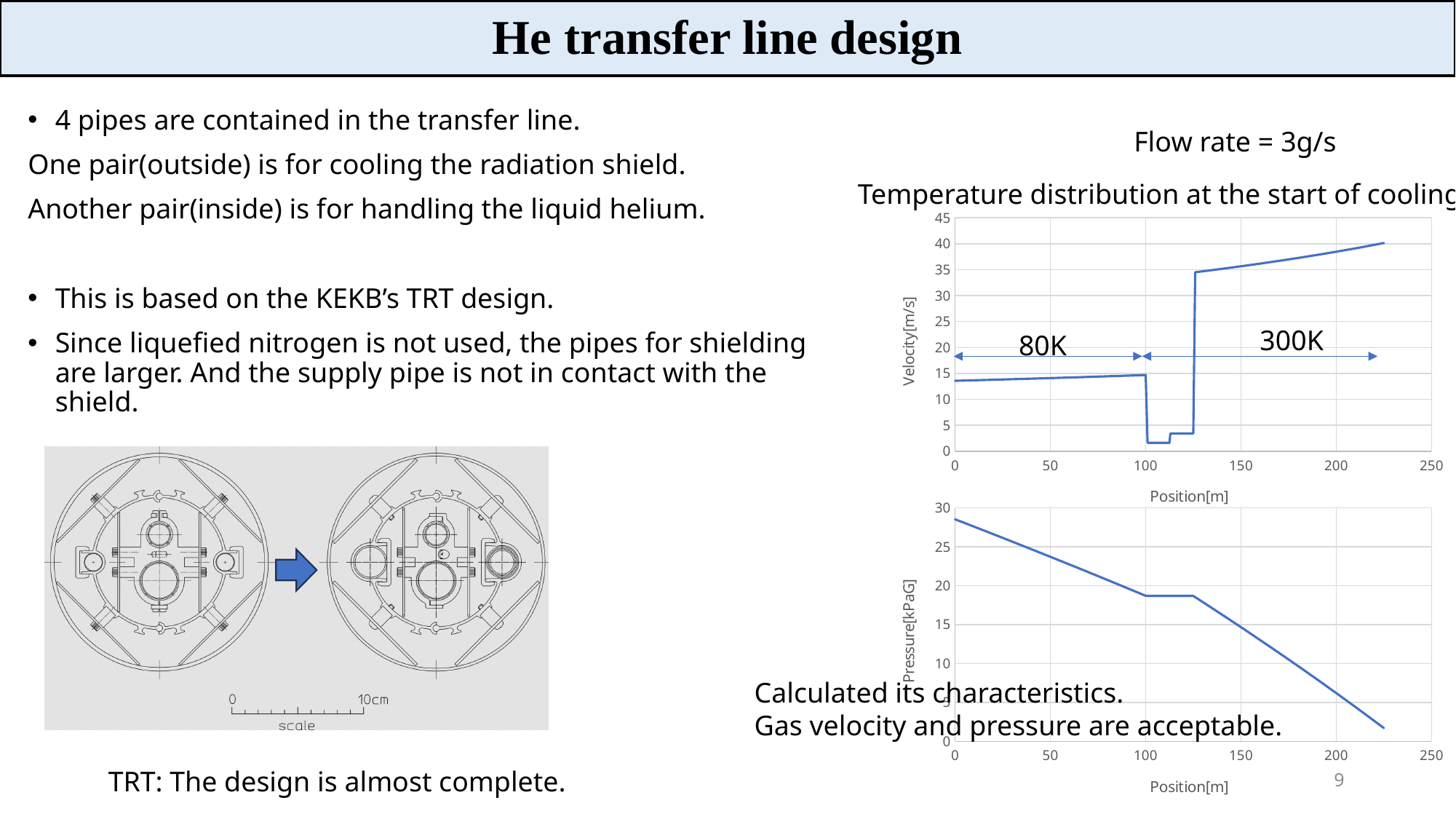
In the top velocity chart, is the velocity at position 225 m greater or less than 35 m/s? greater What is the y-axis label of the bottom chart? Pressure[kPaG] In the top velocity chart, is the velocity higher at position 50 m or at position 200 m? 200 m In the top velocity chart, is the velocity at position 150 m greater or less than 30 m/s? greater How many charts are shown on the slide? 2 In the top velocity chart, is the velocity at position 105 m greater or less than 5 m/s? less What kind of chart is the top chart (Velocity vs Position)? line chart In the bottom pressure chart, does the pressure rise or fall overall as position increases from 0 to 225 m? fall What kind of chart is the bottom chart (Pressure vs Position)? line chart